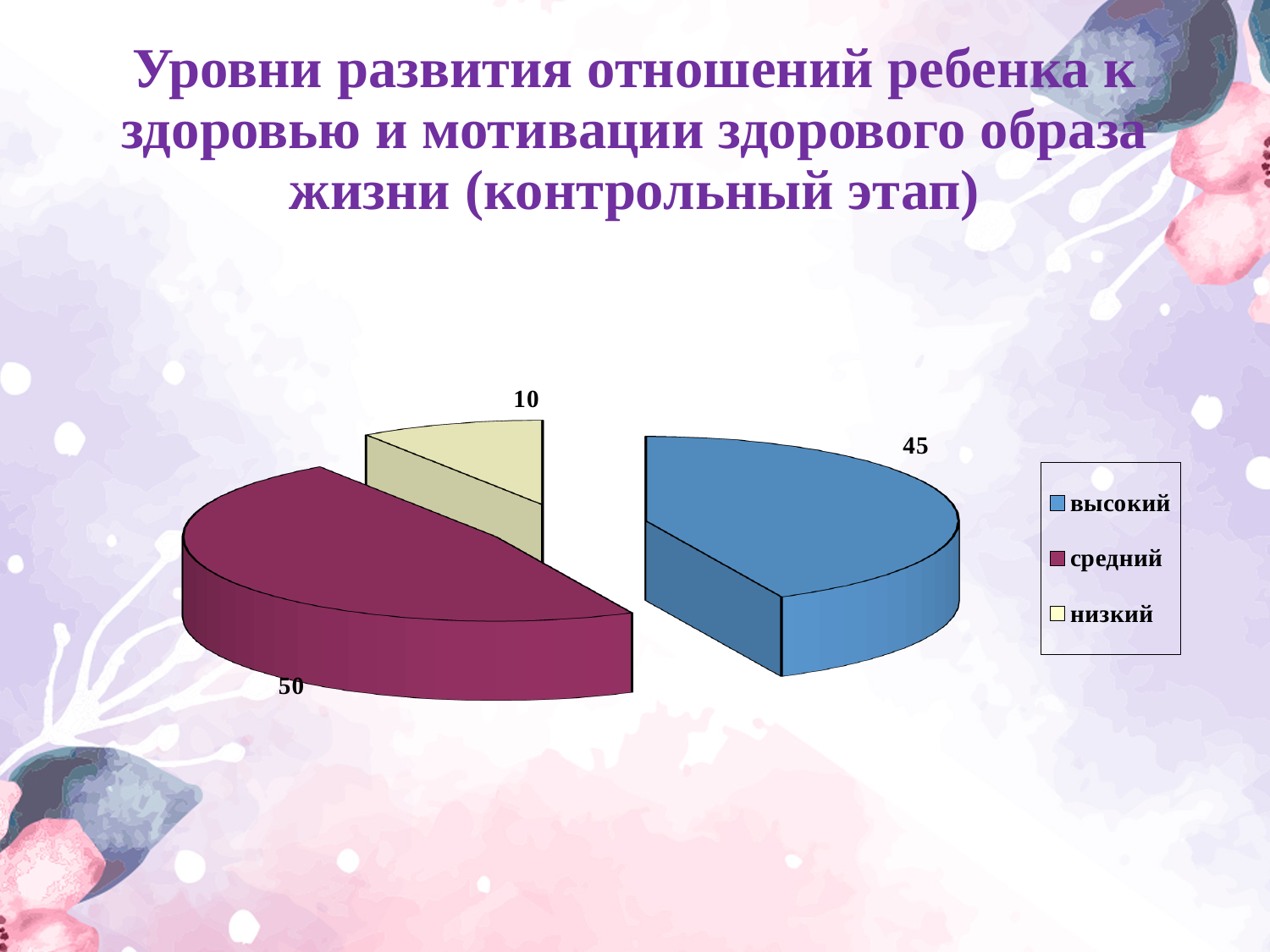
Which category has the lowest value? низкий What is the value for высокий? 45 What is the value for средний? 50 What is the difference between the values for высокий and низкий? 35 How many slices does the pie chart have? 3 Which category has the highest value? средний How many entries does the legend list? 3 What kind of chart is shown on the slide? pie chart Which is larger, the value for высокий or the value for низкий? высокий What colour is the slice for средний? dark pink (magenta) What is the difference between the values for средний and высокий? 5 What is the value for низкий? 10